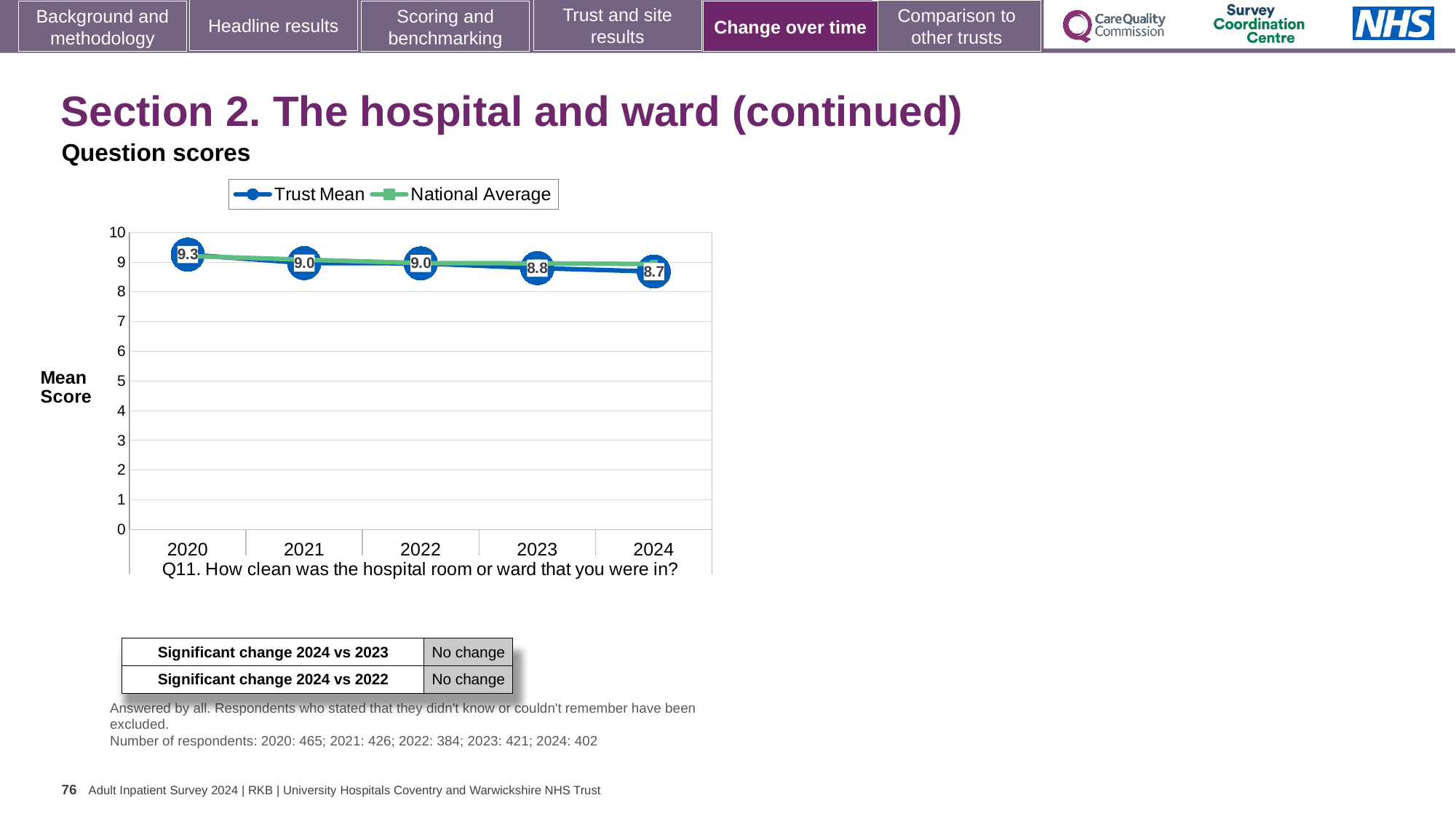
Is the National Average for 2024 greater or less than 8? greater What is the difference between the Trust Mean in 2020 and in 2024? 0.6 What is the Trust Mean for 2023? 8.8 How many series does the legend list? 2 Does the Trust Mean rise or fall from 2020 to 2024? fall What is the Trust Mean for 2024? 8.7 What is the Trust Mean for 2020? 9.3 How many years are shown on the x axis? 5 In which year is the Trust Mean lowest? 2024 Which is larger, the Trust Mean in 2021 or in 2023? 2021 What kind of chart is shown? line chart In which year is the Trust Mean highest? 2020